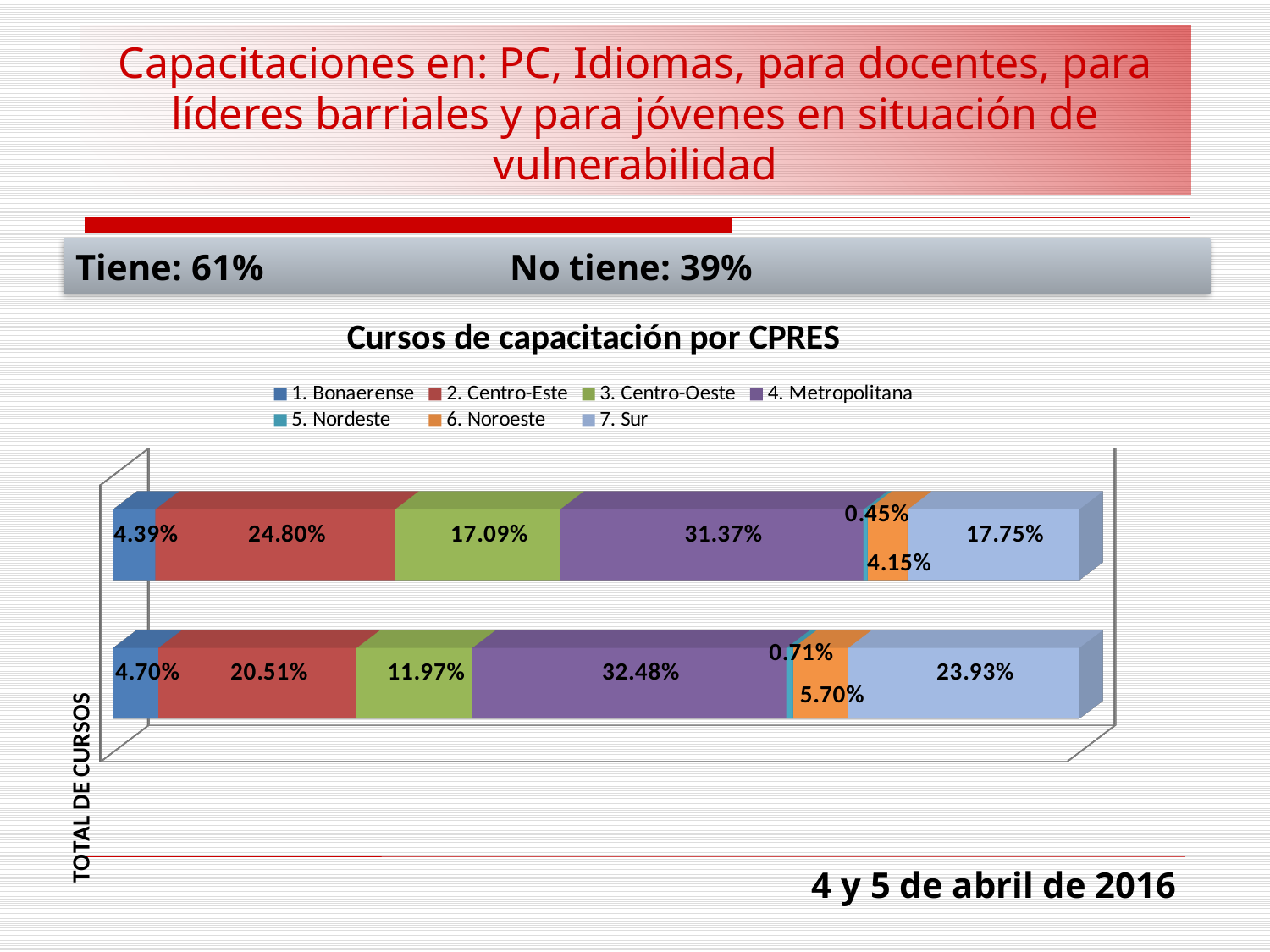
In the bottom bar, which is larger: 2. Centro-Este or 7. Sur? 7. Sur What type of chart is shown under the title 'Cursos de capacitación por CPRES'? Stacked bar chart How many stacked bars are plotted in the chart? 2 How many series does the legend of the chart list? 7 What is the total of the segments in the bottom bar? 100% In the top bar, what is the value for 5. Nordeste? 0.45% What is the title of the chart? Cursos de capacitación por CPRES In the top bar, which series has the smallest value? 5. Nordeste In the top bar, what is the value for 4. Metropolitana? 31.37% In the bottom bar, which series has the largest value? 4. Metropolitana In the bottom bar, what is the value for 7. Sur? 23.93% In the top bar, what is the difference between 2. Centro-Este and 3. Centro-Oeste? 7.71%